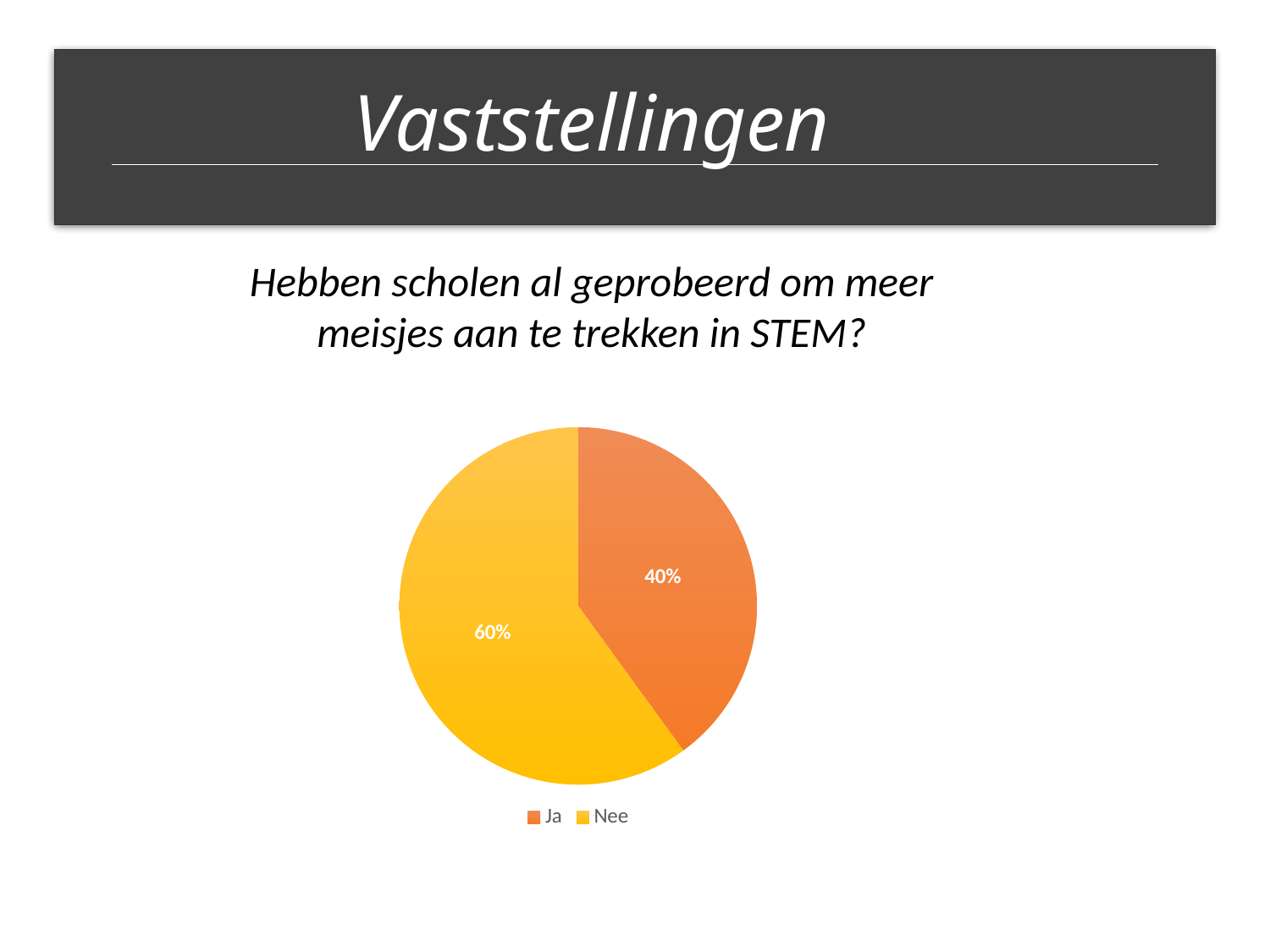
Which slice is the smallest? Ja How many slices does the pie chart have? 2 Which is larger, the "Ja" slice or the "Nee" slice? Nee What share of the pie does "Nee" represent? 60% What question is posed above the pie chart? Hebben scholen al geprobeerd om meer meisjes aan te trekken in STEM? Which slice is the largest? Nee What kind of chart is shown on the slide? pie chart How many entries does the legend list? 2 What colour is the "Ja" slice? orange What is the difference in percentage points between the "Nee" and "Ja" slices? 20% What share of the pie does "Ja" represent? 40%